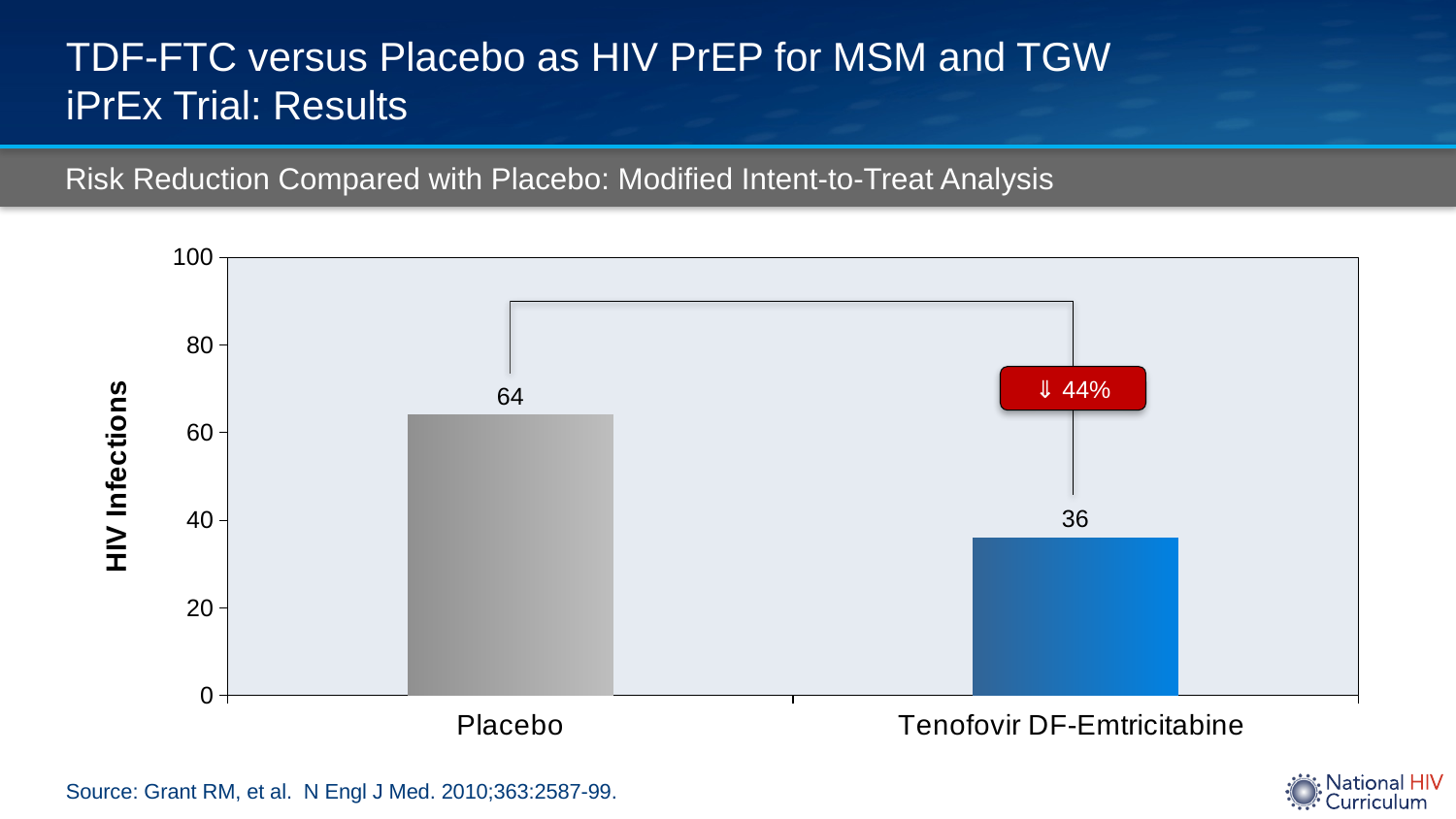
What is the label of the y axis? HIV Infections What percentage risk reduction is shown in the red callout on the chart? 44% How many categories are shown on the x axis of the chart? 2 How many HIV infections are shown for the Placebo group? 64 Which group has the higher number of HIV infections? Placebo What kind of chart is shown on the slide? Bar chart How many HIV infections are shown for the Tenofovir DF-Emtricitabine group? 36 Is the value for Placebo greater or less than 60? greater Which group has the lower number of HIV infections? Tenofovir DF-Emtricitabine What is the difference in HIV infections between the Placebo and Tenofovir DF-Emtricitabine groups? 28 Is the value for Tenofovir DF-Emtricitabine greater or less than 40? less Is the number of HIV infections larger for Placebo or for Tenofovir DF-Emtricitabine? Placebo